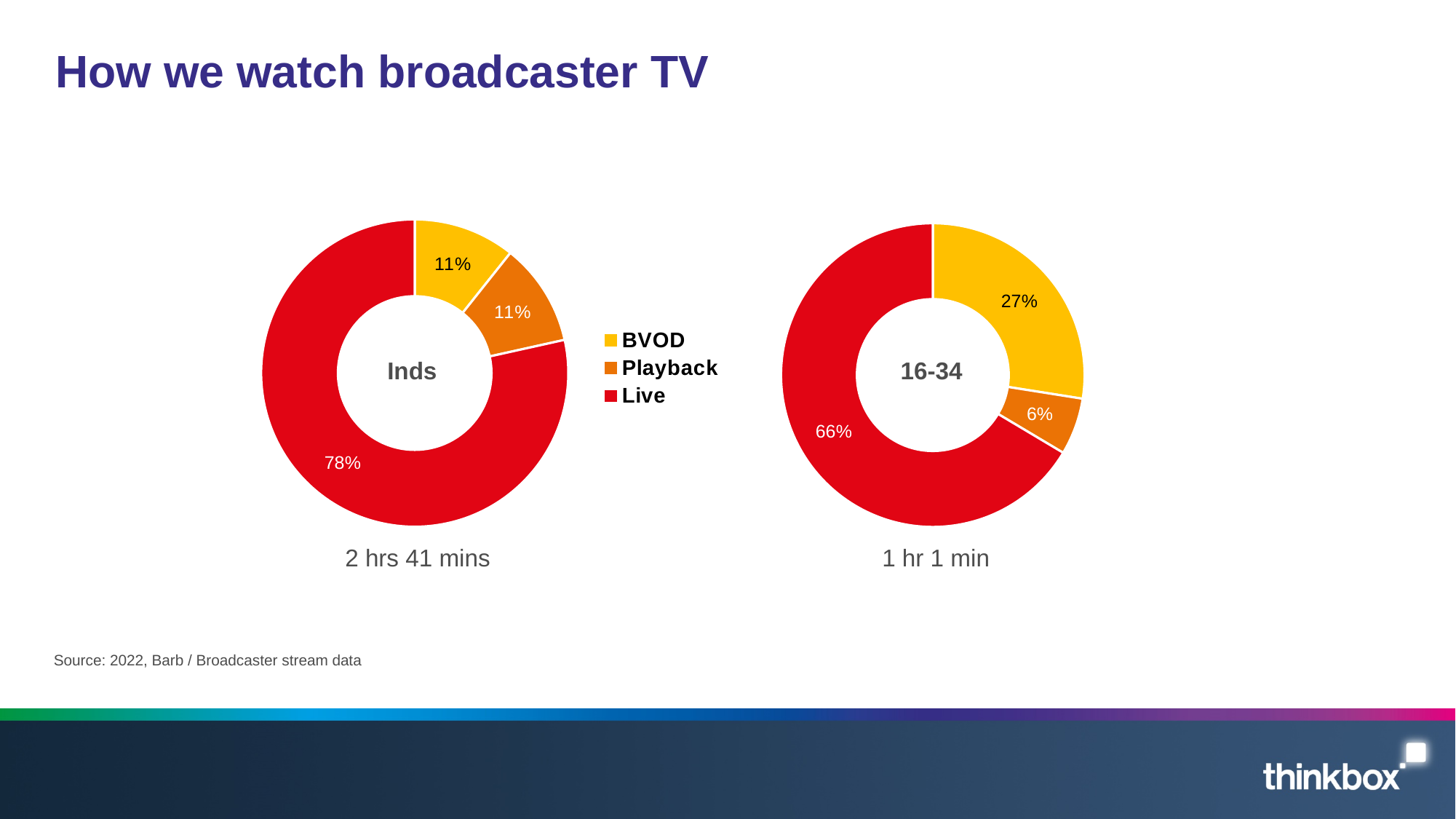
What total viewing time is shown beneath the 16-34 chart? 1 hr 1 min What kind of chart is the Inds chart? Doughnut chart How many series does the legend list? 3 Which is larger: the BVOD share in the 16-34 chart or the BVOD share in the Inds chart? 16-34 In the 16-34 chart, which category has the largest share? Live In the 16-34 chart, what share of viewing is BVOD? 27% In the Inds chart, what share of viewing is BVOD? 11% In the 16-34 chart, which category has the smallest share? Playback What is the difference between the Live share in the Inds chart and the Live share in the 16-34 chart? 12 percentage points In the 16-34 chart, what share of viewing is Playback? 6% In the Inds chart, what share of viewing is Live? 78% In the Inds chart, which category has the largest share? Live